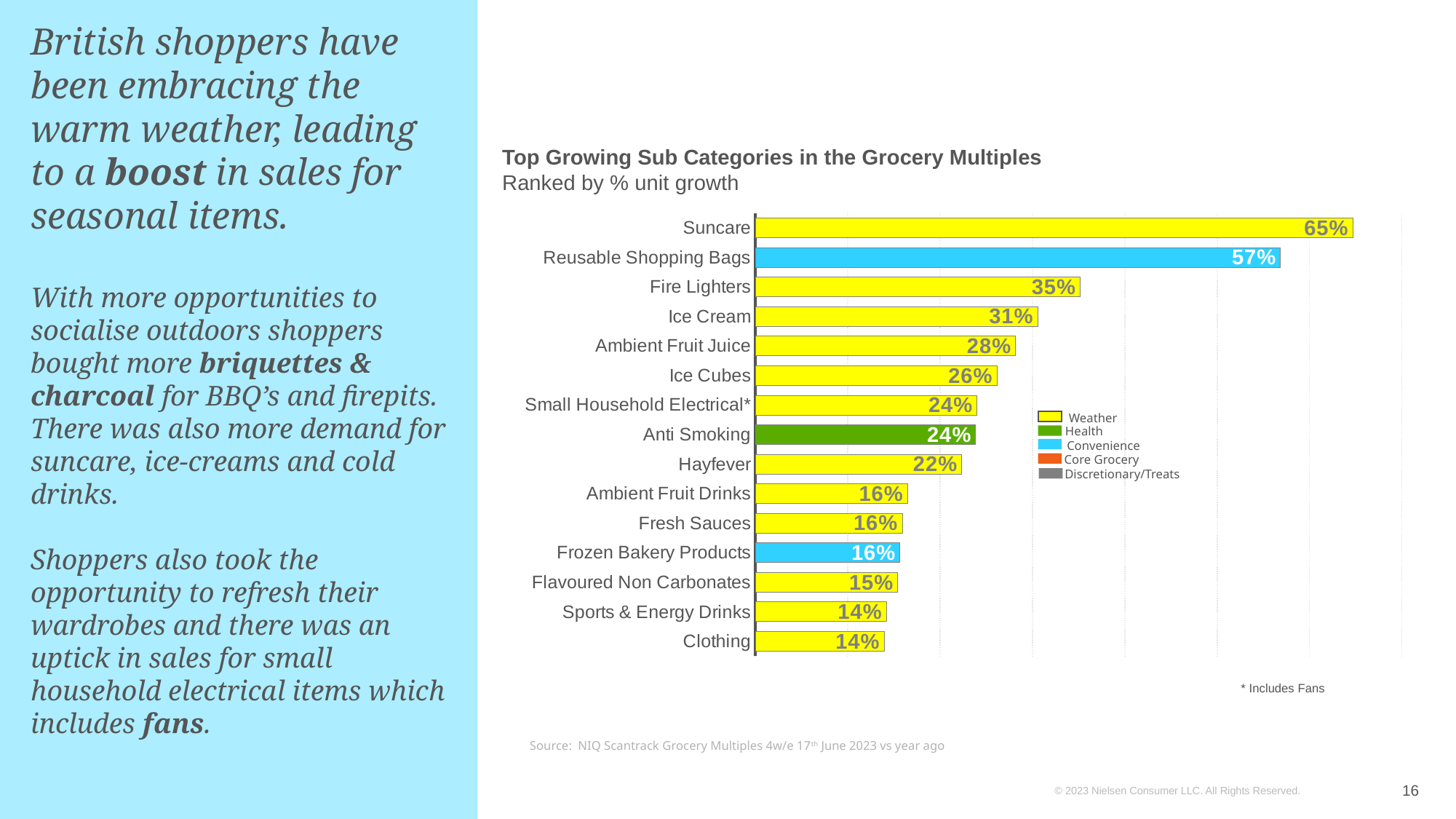
How many entries does the legend list? 5 What is the % unit growth for Hayfever? 22% What is the difference in % unit growth between Suncare and Reusable Shopping Bags? 8% What is the % unit growth for Ice Cream? 31% Which has a higher % unit growth, Ambient Fruit Juice or Ice Cubes? Ambient Fruit Juice What is the % unit growth for Reusable Shopping Bags? 57% What is the difference in % unit growth between Fire Lighters and Ice Cubes? 9% Which legend category does the Anti Smoking bar belong to? Health Which sub category has the highest % unit growth? Suncare How many sub categories are shown in the chart? 15 What is the % unit growth for Suncare? 65% What type of chart is shown on the slide? Bar chart